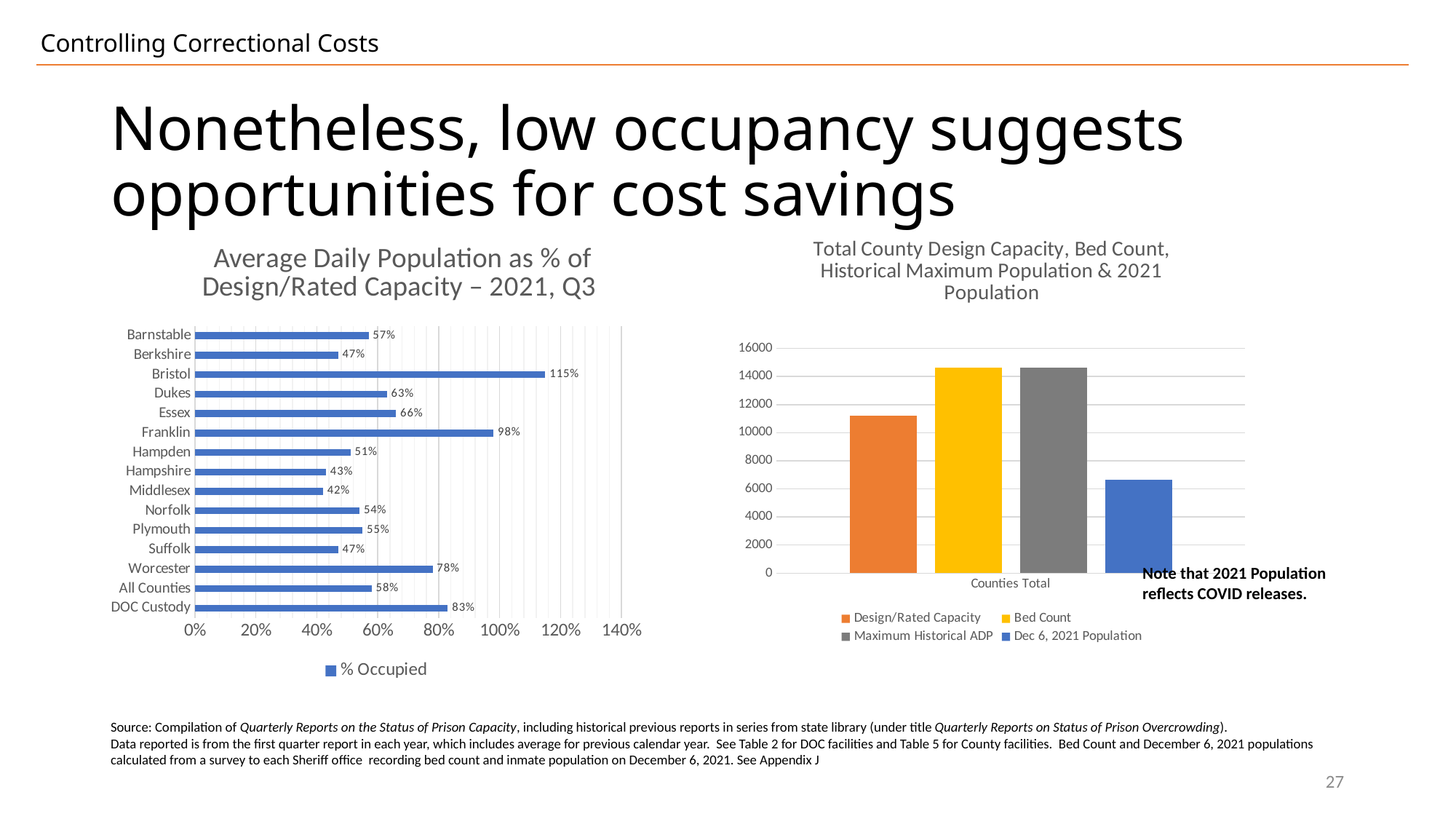
In the 'Total County Design Capacity, Bed Count, Historical Maximum Population & 2021 Population' chart, what colour is the Bed Count bar? Yellow How many series does the legend list in the 'Total County Design Capacity, Bed Count, Historical Maximum Population & 2021 Population' chart? 4 In the 'Average Daily Population as % of Design/Rated Capacity – 2021, Q3' chart, which is larger, Franklin or Essex? Franklin In the 'Average Daily Population as % of Design/Rated Capacity – 2021, Q3' chart, which category has the lowest value? Middlesex In the 'Average Daily Population as % of Design/Rated Capacity – 2021, Q3' chart, what is the value for Bristol? 115% In the 'Total County Design Capacity, Bed Count, Historical Maximum Population & 2021 Population' chart, is the value for Design/Rated Capacity greater or less than 10000? greater In the 'Average Daily Population as % of Design/Rated Capacity – 2021, Q3' chart, what is the value for DOC Custody? 83% In the 'Total County Design Capacity, Bed Count, Historical Maximum Population & 2021 Population' chart, which series has the lowest value? Dec 6, 2021 Population In the 'Average Daily Population as % of Design/Rated Capacity – 2021, Q3' chart, which category has the highest value? Bristol In the 'Average Daily Population as % of Design/Rated Capacity – 2021, Q3' chart, what is the difference between Worcester and All Counties? 20% How many categories are shown in the 'Average Daily Population as % of Design/Rated Capacity – 2021, Q3' chart? 15 What kind of chart is the 'Average Daily Population as % of Design/Rated Capacity – 2021, Q3' chart? Bar chart